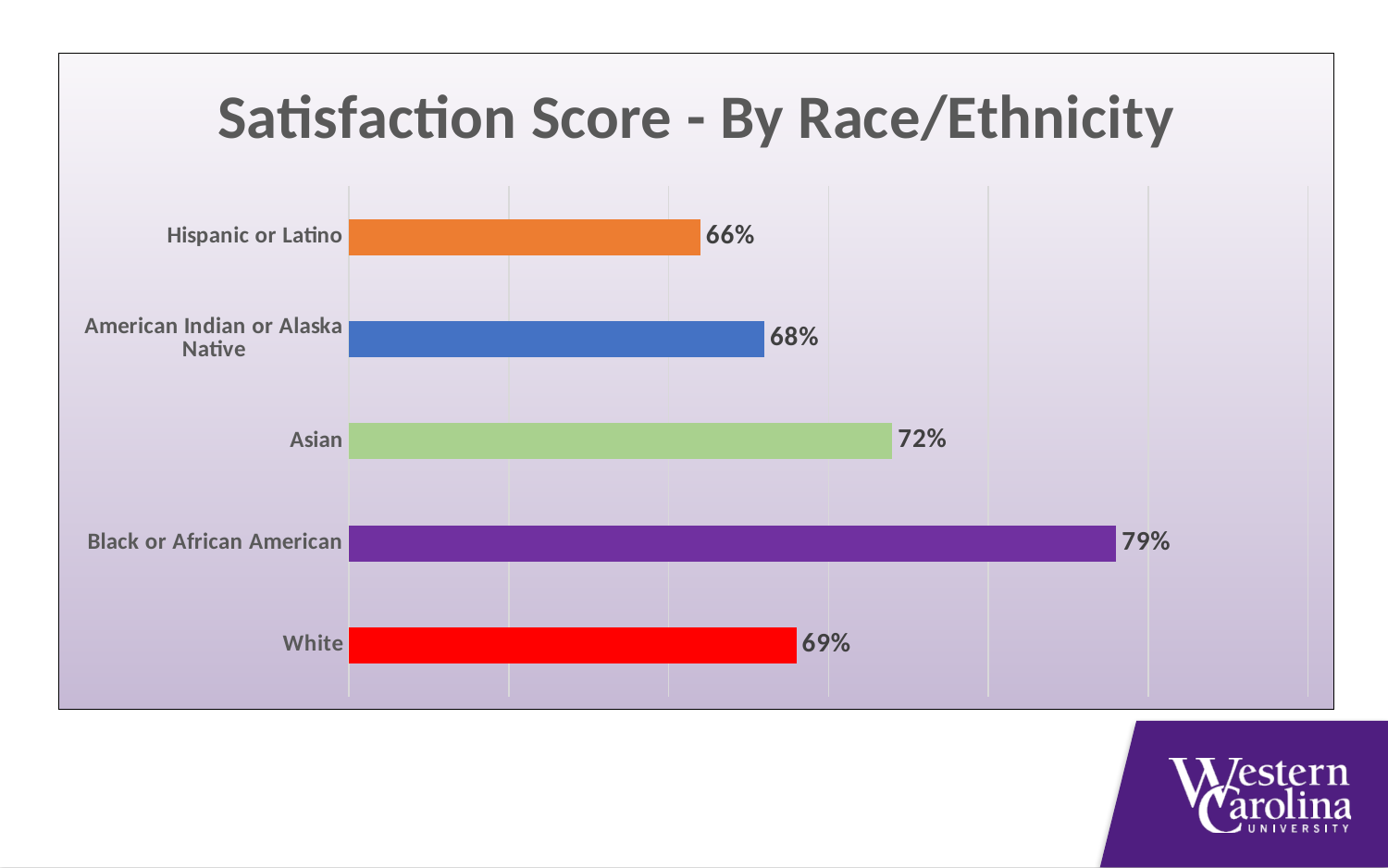
Which has a higher satisfaction score, Asian or White? Asian Which race/ethnicity group has the highest satisfaction score? Black or African American What is the difference between the satisfaction scores for Black or African American and Hispanic or Latino? 13% What is the satisfaction score for White? 69% What is the title of the chart? Satisfaction Score - By Race/Ethnicity Which race/ethnicity group has the lowest satisfaction score? Hispanic or Latino How many race/ethnicity categories are shown in the chart? 5 What kind of chart is shown on the slide? Bar chart What is the satisfaction score for Hispanic or Latino? 66% What is the difference between the satisfaction scores for Asian and White? 3% What is the satisfaction score for Black or African American? 79% What is the satisfaction score for American Indian or Alaska Native? 68%